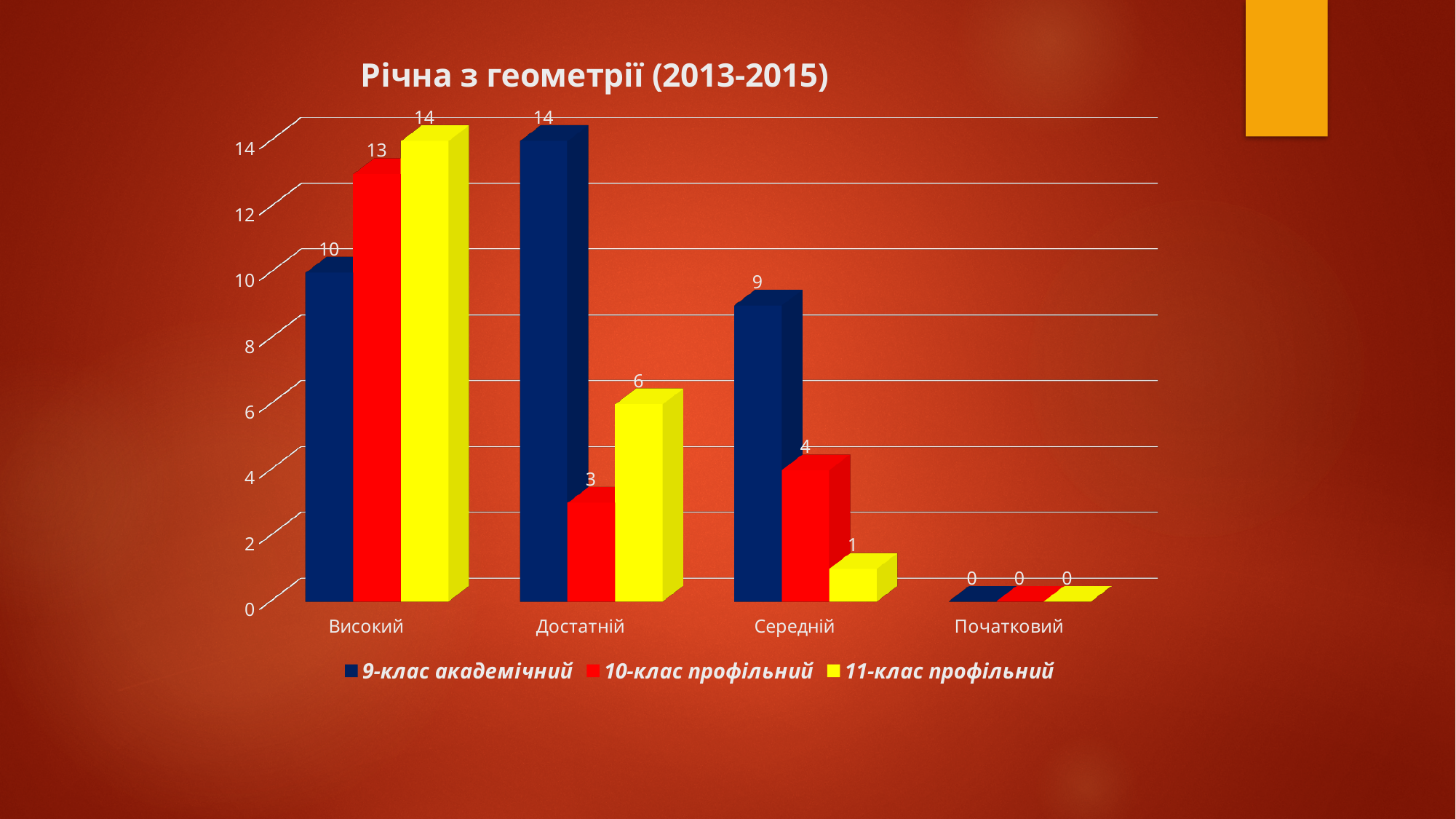
What is the value for 10-клас профільний in the Достатній category? 3 Which category has the lowest value for 11-клас профільний? Початковий Which category has the highest value for 9-клас академічний? Достатній How many categories are shown on the x axis? 4 What is the value for 11-клас профільний in the Середній category? 1 In the Середній category, which is larger: 9-клас академічний or 10-клас профільний? 9-клас академічний What is the value for 9-клас академічний in the Високий category? 10 What is the difference between the 11-клас профільний and 10-клас профільний values in the Достатній category? 3 What kind of chart is shown on the slide? bar chart What is the title of the chart? Річна з геометрії (2013-2015) How many series does the legend list? 3 Do the values for 11-клас профільний rise or fall from Високий to Початковий? fall